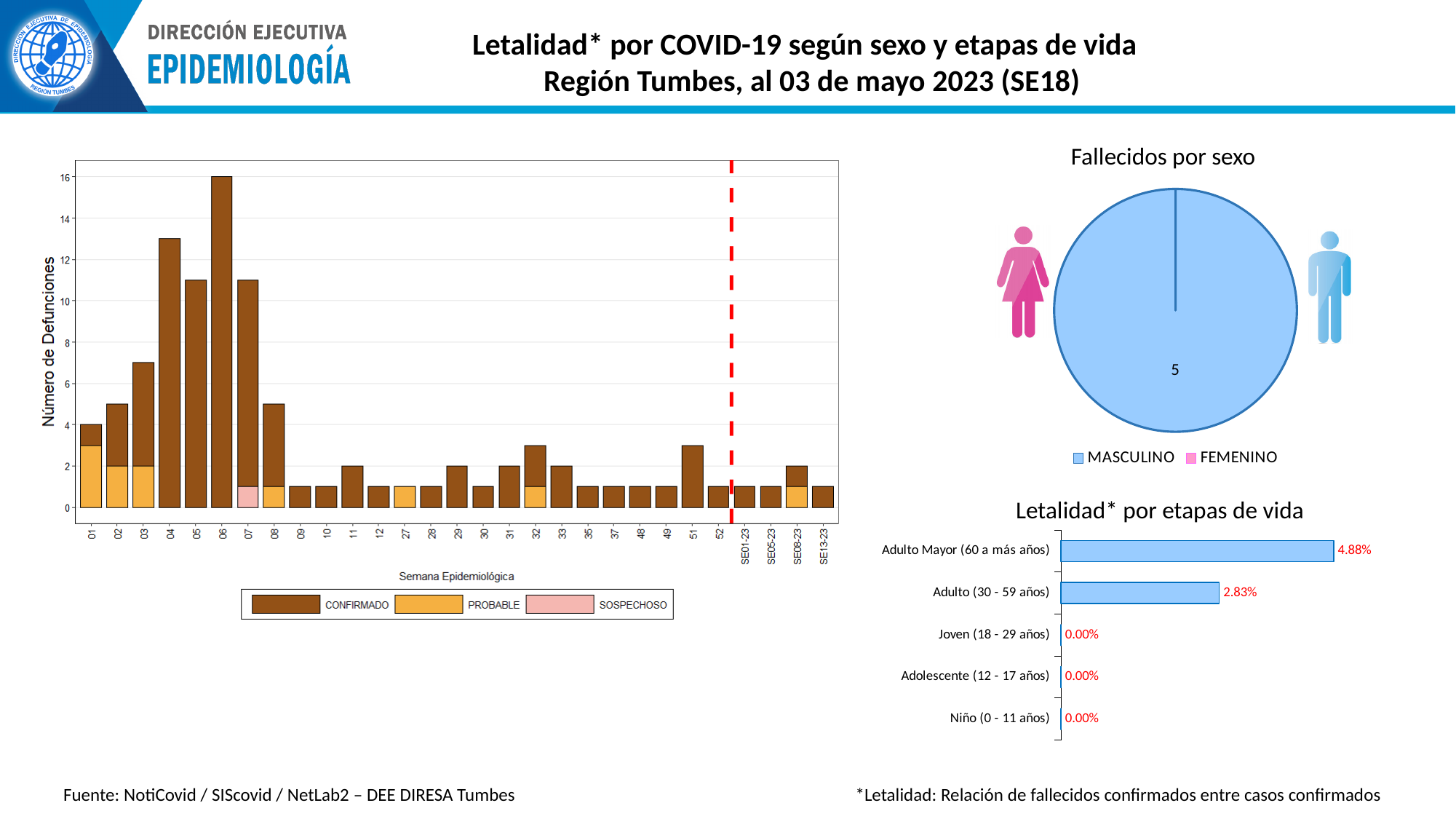
In the 'Letalidad* por etapas de vida' chart, how many age groups are shown? 5 In the 'Letalidad* por etapas de vida' chart, which age group has the highest value? Adulto Mayor (60 a más años) In the 'Letalidad* por etapas de vida' chart, what is the value for Adulto Mayor (60 a más años)? 4.88% How many series does the legend of the left chart of deaths by epidemiological week list? 3 In the 'Letalidad* por etapas de vida' chart, what is the difference between the values for Adulto Mayor (60 a más años) and Adulto (30 - 59 años)? 2.05% In the 'Fallecidos por sexo' pie chart, what value is printed on the MASCULINO slice? 5 In the left chart of deaths by epidemiological week, is the value for week 04 greater or less than 12? greater How many entries does the legend of the 'Fallecidos por sexo' pie chart list? 2 In the left chart of deaths by epidemiological week, which week has the highest number of deaths? 06 In the 'Letalidad* por etapas de vida' chart, what is the value for Joven (18 - 29 años)? 0.00% In the 'Letalidad* por etapas de vida' chart, what is the value for Adulto (30 - 59 años)? 2.83% In the left chart of deaths by epidemiological week, what is the total number of deaths in week 06? 16